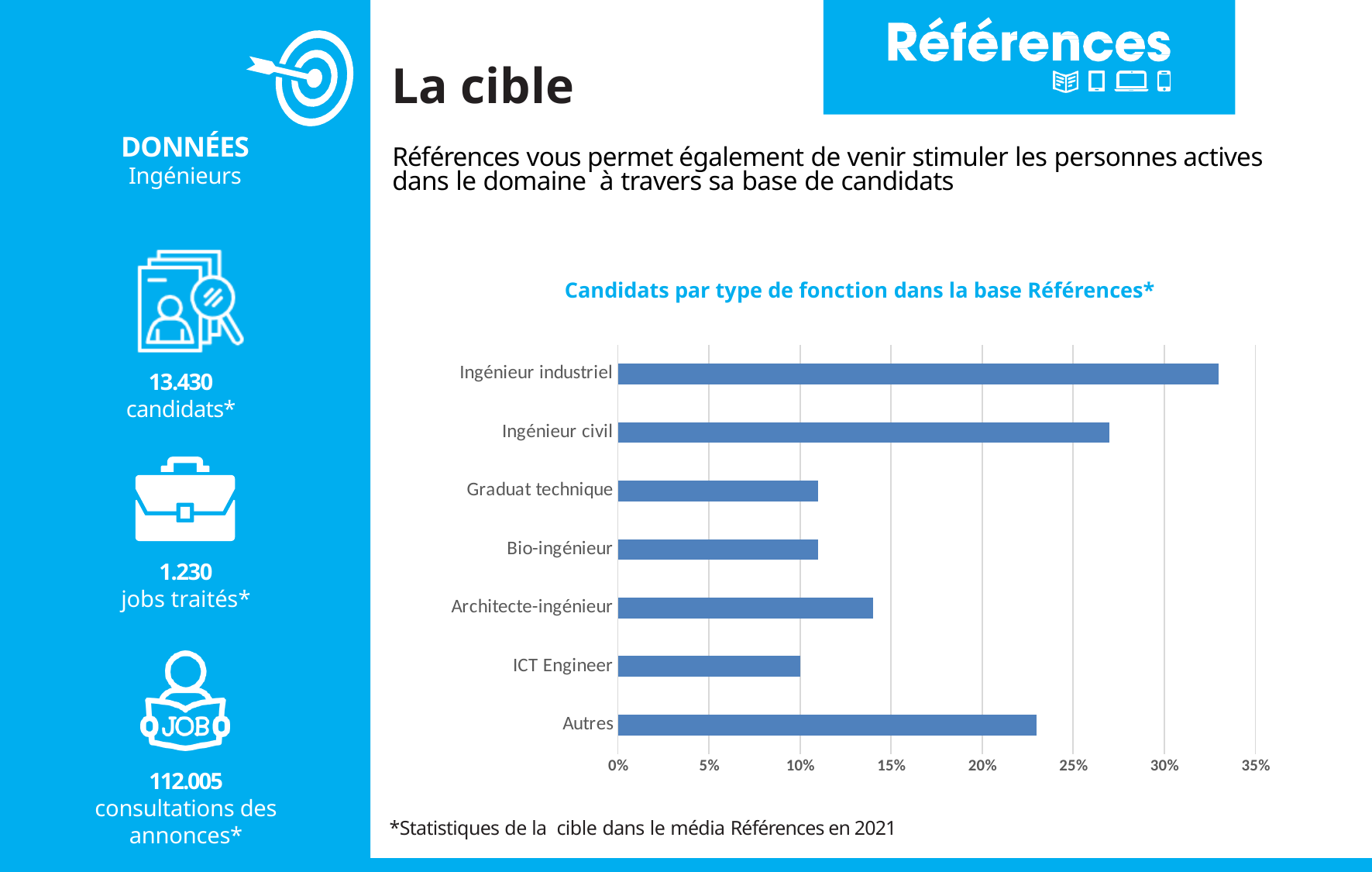
Which is larger, the value for Ingénieur civil or the value for Autres? Ingénieur civil Which is larger, the value for Architecte-ingénieur or the value for Graduat technique? Architecte-ingénieur What is the title of the chart? Candidats par type de fonction dans la base Références* Is the value for Ingénieur civil greater or less than 25%? greater Is the value for Autres greater or less than 20%? greater Which function type has the highest share of candidates? Ingénieur industriel Is the value for Architecte-ingénieur greater or less than 15%? less What is the highest value shown on the horizontal axis of the chart? 35% How many function types (categories) are shown in the chart? 7 What kind of chart is shown on the slide? bar chart